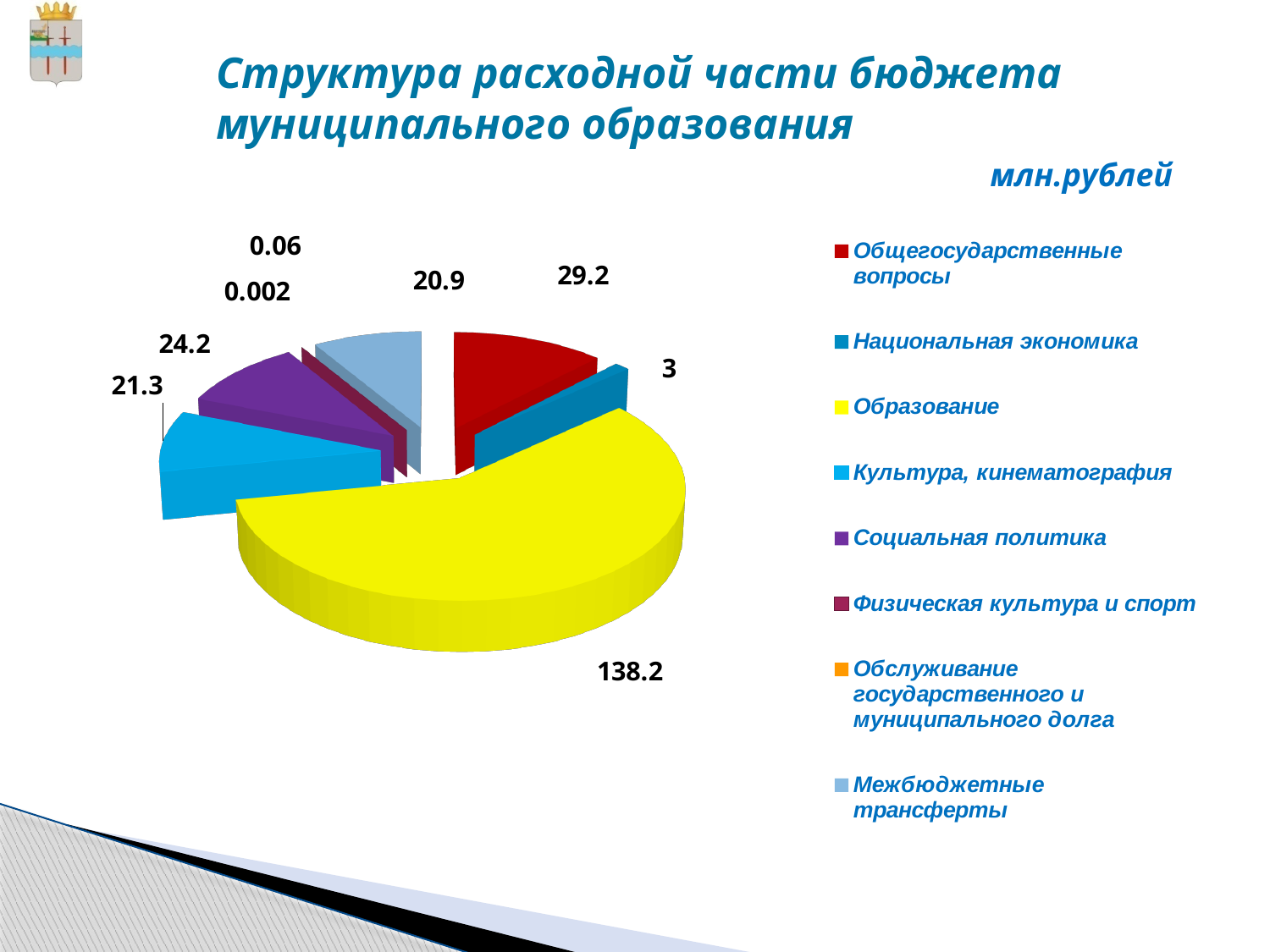
What is the value for Общегосударственные вопросы? 29.2 Which category has the largest slice of the pie? Образование What unit is stated for the values on the slide? млн.рублей What is the value for Образование? 138.2 How many categories does the legend list? 8 Which is larger, Социальная политика or Культура, кинематография? Социальная политика What is the value for Национальная экономика? 3 What is the difference between the values for Общегосударственные вопросы and Национальная экономика? 26.2 Which category has the smallest value? Обслуживание государственного и муниципального долга What is the value for Межбюджетные трансферты? 20.9 What type of chart is shown on the slide? pie chart What is the value for Социальная политика? 24.2